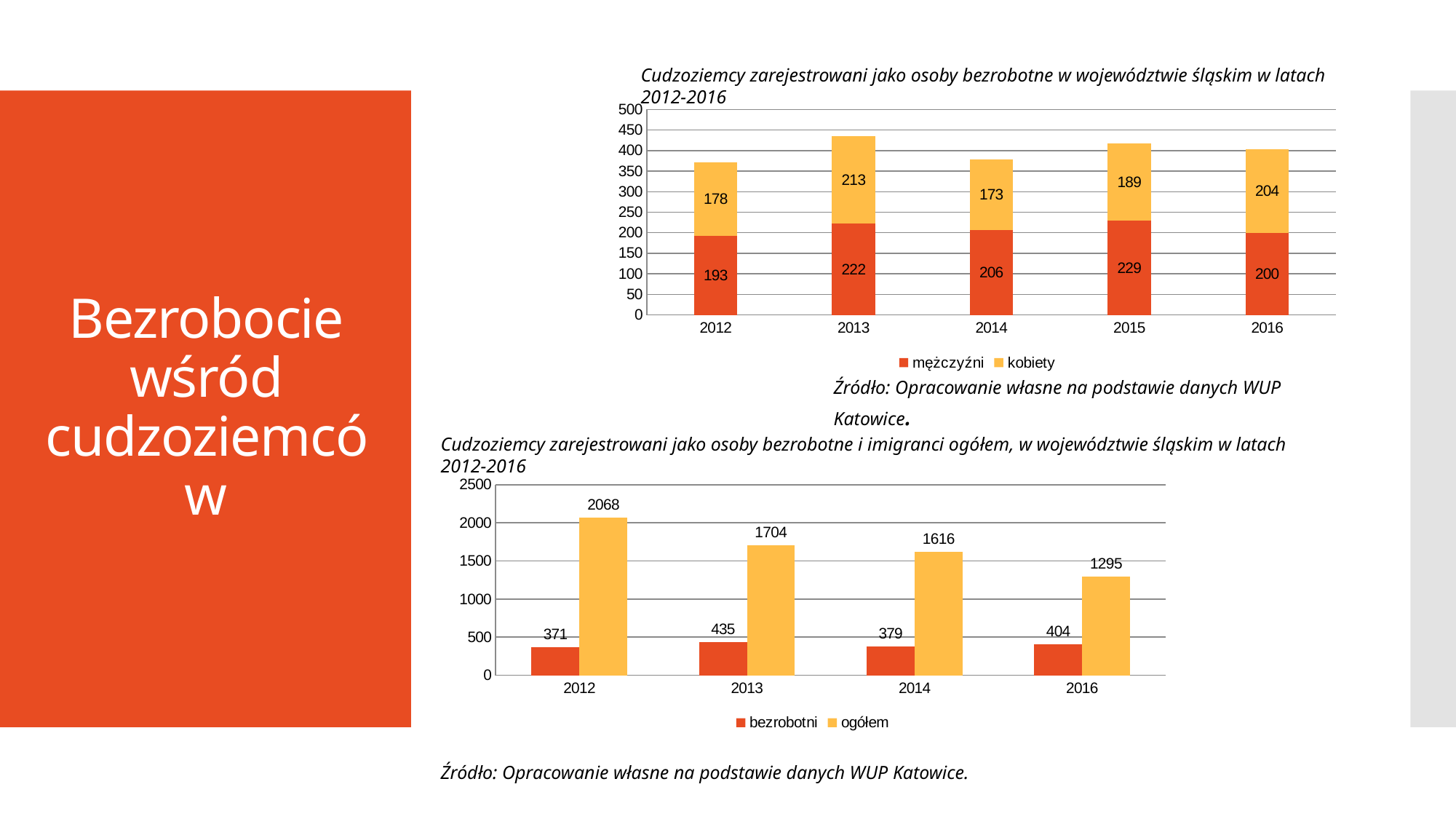
In the bottom chart, what is the difference between ogółem and bezrobotni in 2012? 1697 In the top chart, what is the total of the stacked bar for 2013? 435 In the top chart, how many series does the legend list? 2 In the top chart, what is the value for mężczyźni in 2015? 229 In the bottom chart, does the value for ogółem rise or fall from 2012 to 2016? fall In the top chart, which year has the lowest value for mężczyźni? 2012 In the bottom chart, how many years are shown on the x axis? 4 In the bottom chart, what is the value for bezrobotni in 2016? 404 In the top chart, what is the value for kobiety in 2014? 173 In the top chart, what is the difference between mężczyźni and kobiety in 2016? 4 In the top chart, which year has the highest value for kobiety? 2013 In the bottom chart, what is the value for ogółem in 2014? 1616